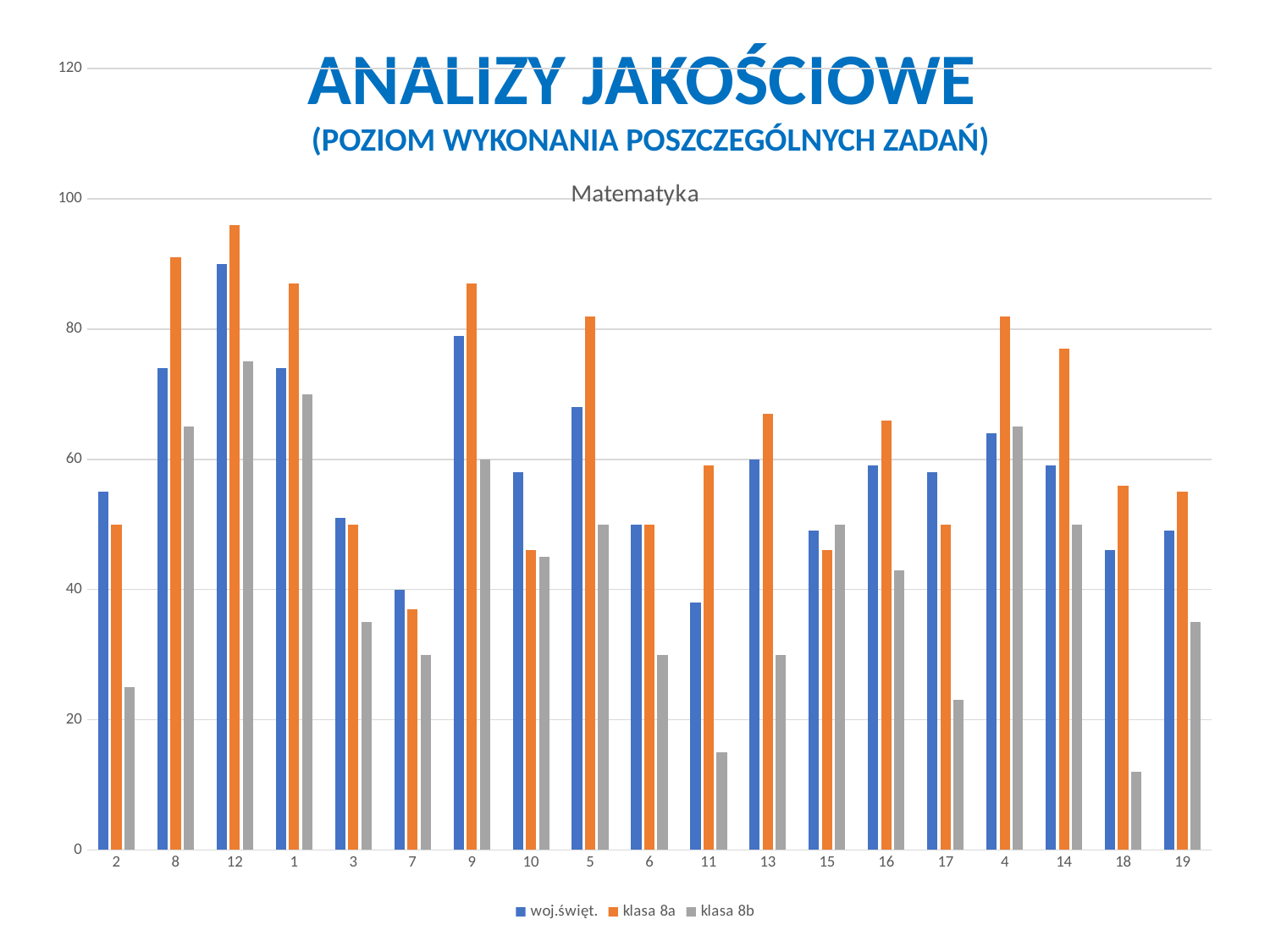
For which category is the klasa 8b value lowest? 18 For which category is the klasa 8a value highest? 12 How many categories are shown on the x axis? 19 Is the klasa 8a value for category 8 greater or less than 80? greater For category 11, which is larger: the woj.święt. value or the klasa 8a value? klasa 8a For which category is the woj.święt. value highest? 12 Is the klasa 8b value for category 2 greater or less than 40? less What is the title shown above the chart's plot area? Matematyka Is the klasa 8b value for category 11 greater or less than 20? less Which series is shown in orange? klasa 8a What kind of chart is shown on the slide? bar chart How many series does the legend list? 3